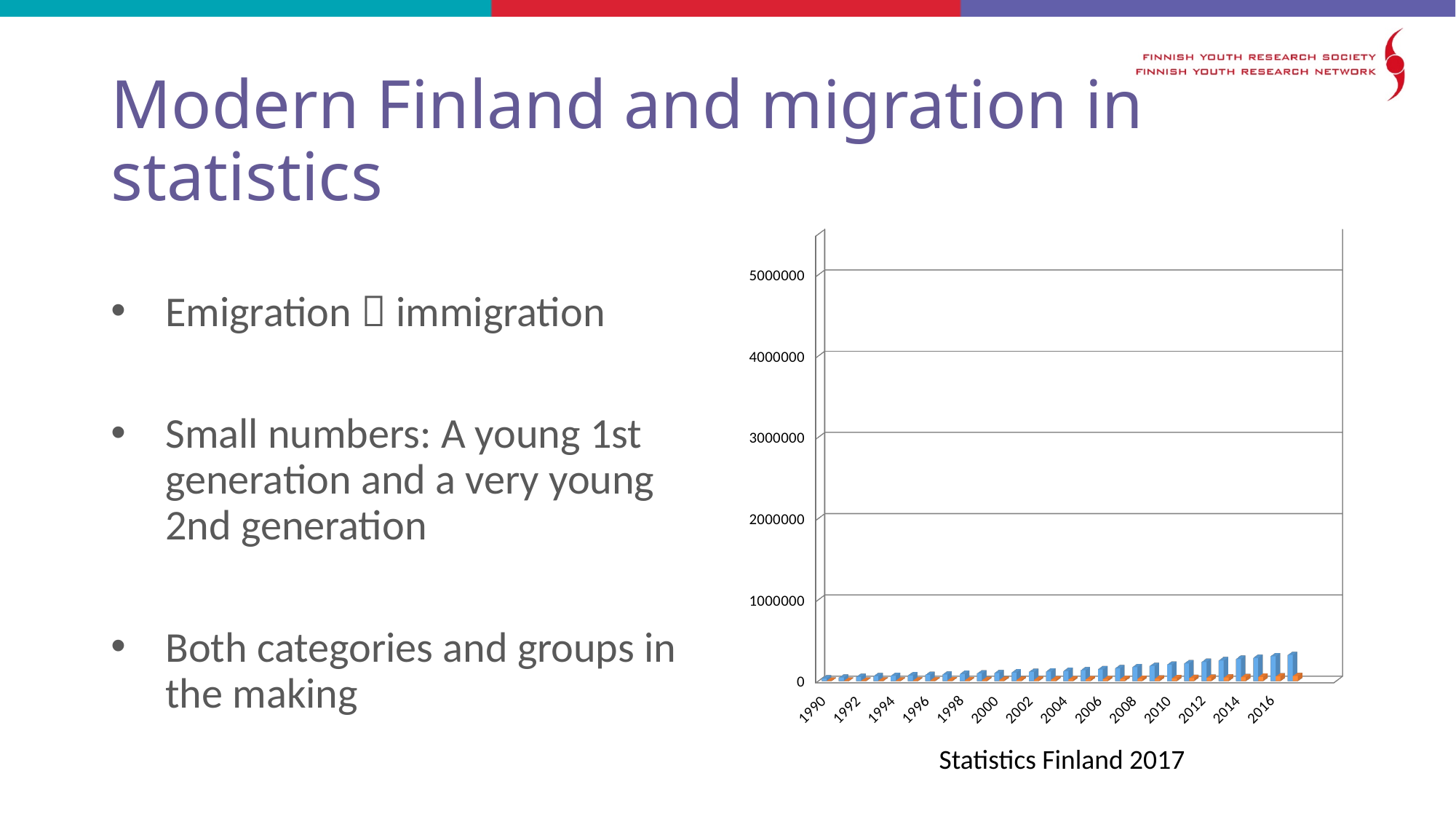
How many differently coloured bar series are plotted in the chart? 2 What kind of chart is shown on the slide? bar chart What source is cited below the chart? Statistics Finland 2017 For 2016, which bar is taller, the blue one or the orange one? blue What is the first year labelled on the horizontal axis of the chart? 1990 What is the last year labelled on the horizontal axis of the chart? 2016 How many year labels are shown on the horizontal axis of the chart? 14 Do the blue bars rise or fall from 1990 to 2016? rise Is the value of the blue bar for 1990 greater or less than 1000000? less Is the value of the blue bar for 2016 greater or less than 1000000? less What is the highest value labelled on the vertical axis of the chart? 5000000